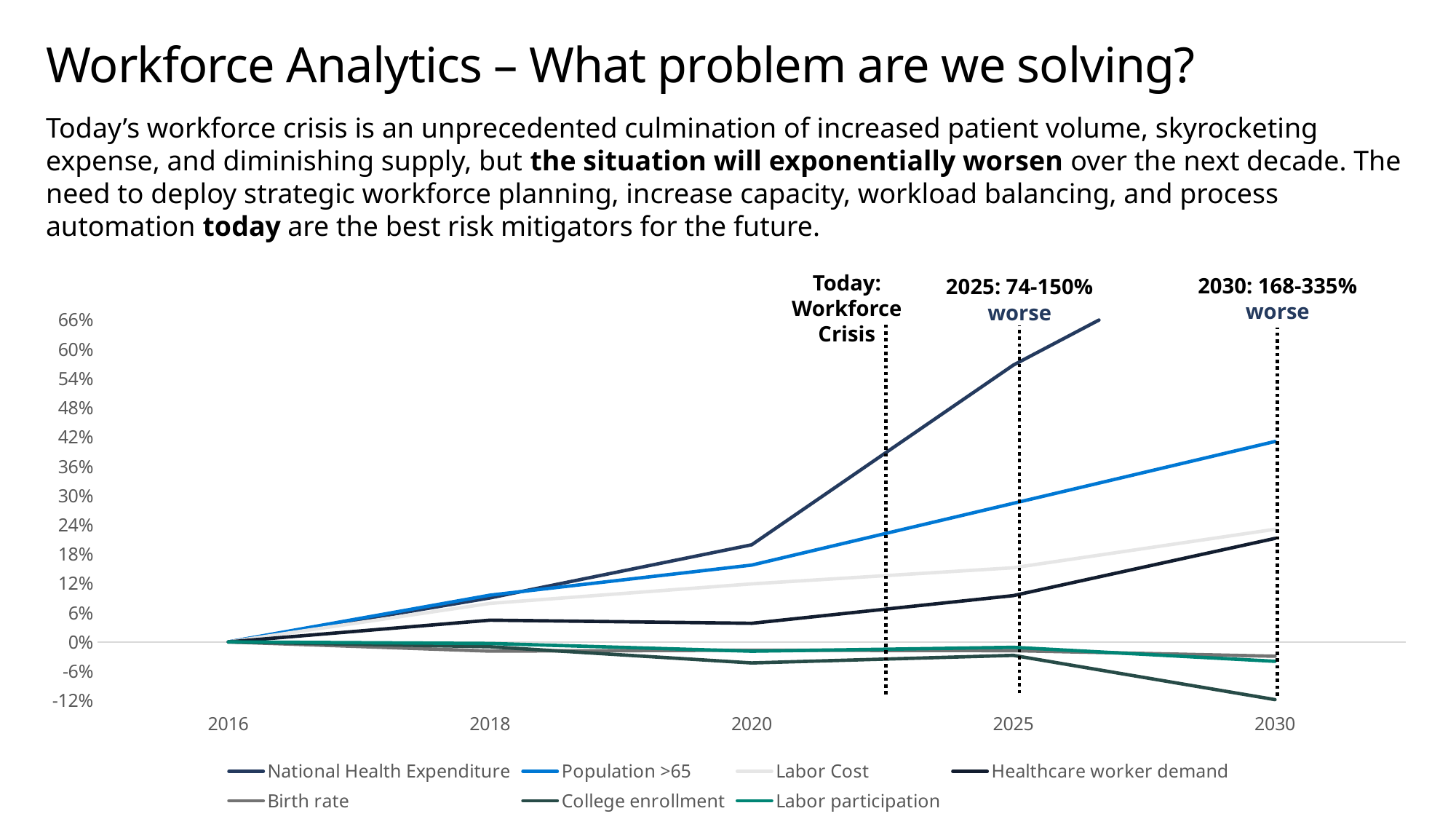
What kind of chart is shown on the slide? line chart How many years are labelled on the x axis? 5 Does the College enrollment line rise or fall between 2025 and 2030? fall Is the value for College enrollment in 2030 greater or less than -6%? less Which series has the lowest value in 2030? College enrollment What value do all the series share in 2016? 0% In 2030, which is larger: Population >65 or Labor Cost? Population >65 Is the value for Population >65 in 2030 greater or less than 36%? greater How many series does the legend list? 7 What does the annotation above the 2030 dotted line say? 2030: 168-335% worse Is the value for National Health Expenditure in 2025 greater or less than 54%? greater Does the National Health Expenditure line rise or fall from 2016 onward? rise